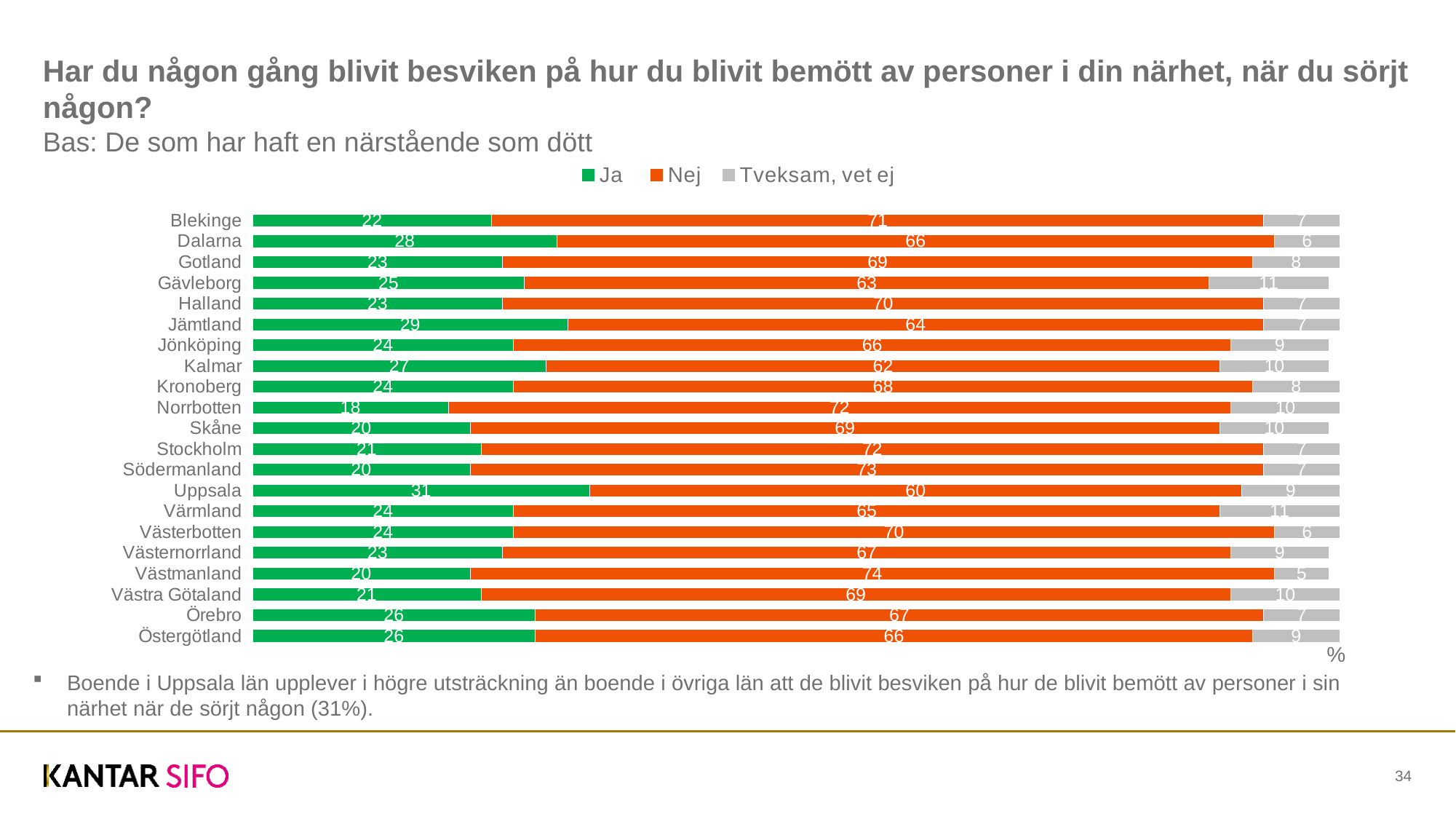
What is the value for Ja for Uppsala? 31 How many regions are shown in the chart? 21 What is the value for Tveksam, vet ej for Gävleborg? 11 What is the total of the stacked bar for Blekinge? 100 Which region has the highest value for Ja? Uppsala Which region has the lowest value for Nej? Uppsala What is the value for Nej for Västmanland? 74 What kind of chart is shown on the slide? Stacked bar chart How many series does the legend list? 3 What is the difference between the Ja value for Uppsala and the Ja value for Norrbotten? 13 Which region has the lowest value for Ja? Norrbotten Which is larger, the Ja value for Dalarna or the Ja value for Kalmar? Dalarna